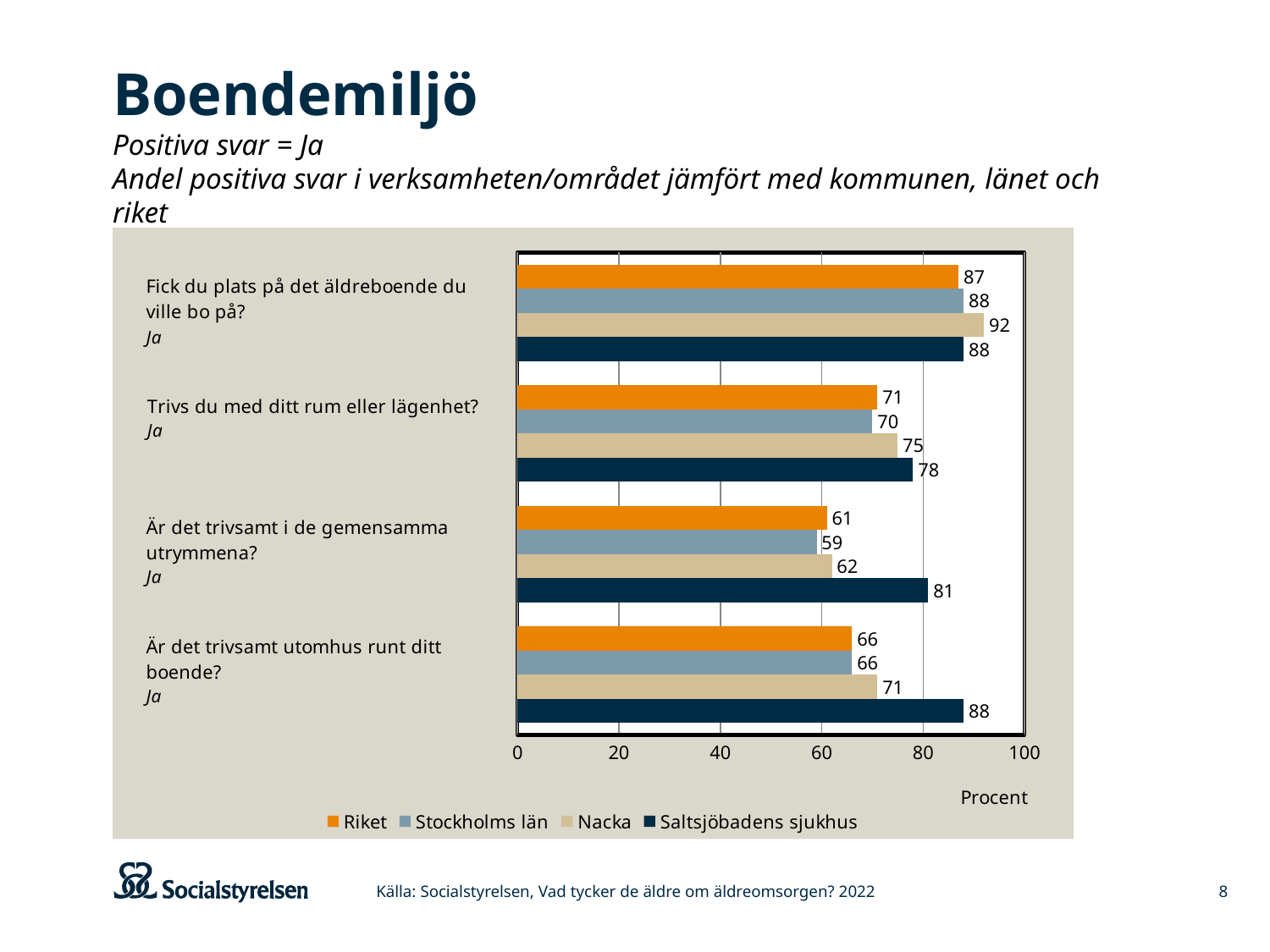
What is the value for Stockholms län on "Är det trivsamt utomhus runt ditt boende?"? 66 What is the value for Riket on "Trivs du med ditt rum eller lägenhet?"? 71 How many series does the legend list? 4 What is the value for Nacka on "Fick du plats på det äldreboende du ville bo på?"? 92 Which series has the highest value on "Är det trivsamt i de gemensamma utrymmena?"? Saltsjöbadens sjukhus What is the value for Saltsjöbadens sjukhus on "Är det trivsamt i de gemensamma utrymmena?"? 81 What kind of chart is shown on the slide? Bar chart What is the difference between Saltsjöbadens sjukhus and Riket on "Är det trivsamt utomhus runt ditt boende?"? 22 How many questions (categories) are shown on the chart? 4 Which series has the lowest value on "Är det trivsamt i de gemensamma utrymmena?"? Stockholms län What unit is shown on the x axis of the chart? Procent Which is larger on "Trivs du med ditt rum eller lägenhet?": Nacka or Saltsjöbadens sjukhus? Saltsjöbadens sjukhus